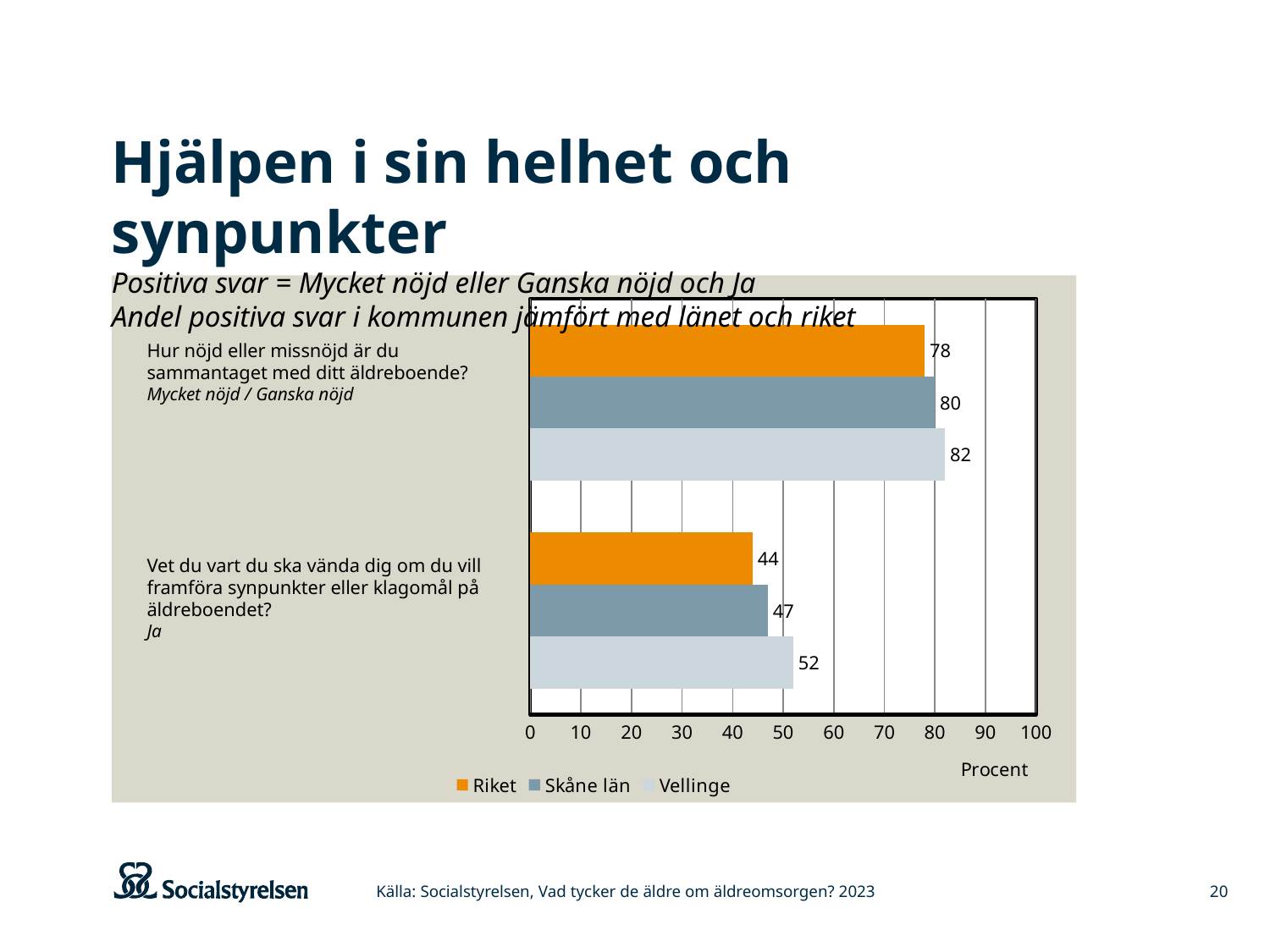
Which series has the lowest value on the question "Hur nöjd eller missnöjd är du sammantaget med ditt äldreboende?"? Riket What is the difference between Vellinge and Skåne län on the question "Hur nöjd eller missnöjd är du sammantaget med ditt äldreboende?"? 2 How many series does the legend list? 3 What is the label on the horizontal axis of the chart? Procent Which is larger: the Riket value for "Hur nöjd eller missnöjd är du sammantaget med ditt äldreboende?" or the Vellinge value for "Vet du vart du ska vända dig om du vill framföra synpunkter eller klagomål på äldreboendet?"? Riket value for "Hur nöjd eller missnöjd är du sammantaget med ditt äldreboende?" What is the difference between Vellinge and Riket on the question "Vet du vart du ska vända dig om du vill framföra synpunkter eller klagomål på äldreboendet?"? 8 What is the value for Riket on the question "Vet du vart du ska vända dig om du vill framföra synpunkter eller klagomål på äldreboendet?"? 44 What is the value for Skåne län on the question "Hur nöjd eller missnöjd är du sammantaget med ditt äldreboende?"? 80 What kind of chart is shown on the slide? Bar chart What is the value for Skåne län on the question "Vet du vart du ska vända dig om du vill framföra synpunkter eller klagomål på äldreboendet?"? 47 What is the value for Vellinge on the question "Hur nöjd eller missnöjd är du sammantaget med ditt äldreboende?"? 82 Which series has the highest value on the question "Vet du vart du ska vända dig om du vill framföra synpunkter eller klagomål på äldreboendet?"? Vellinge